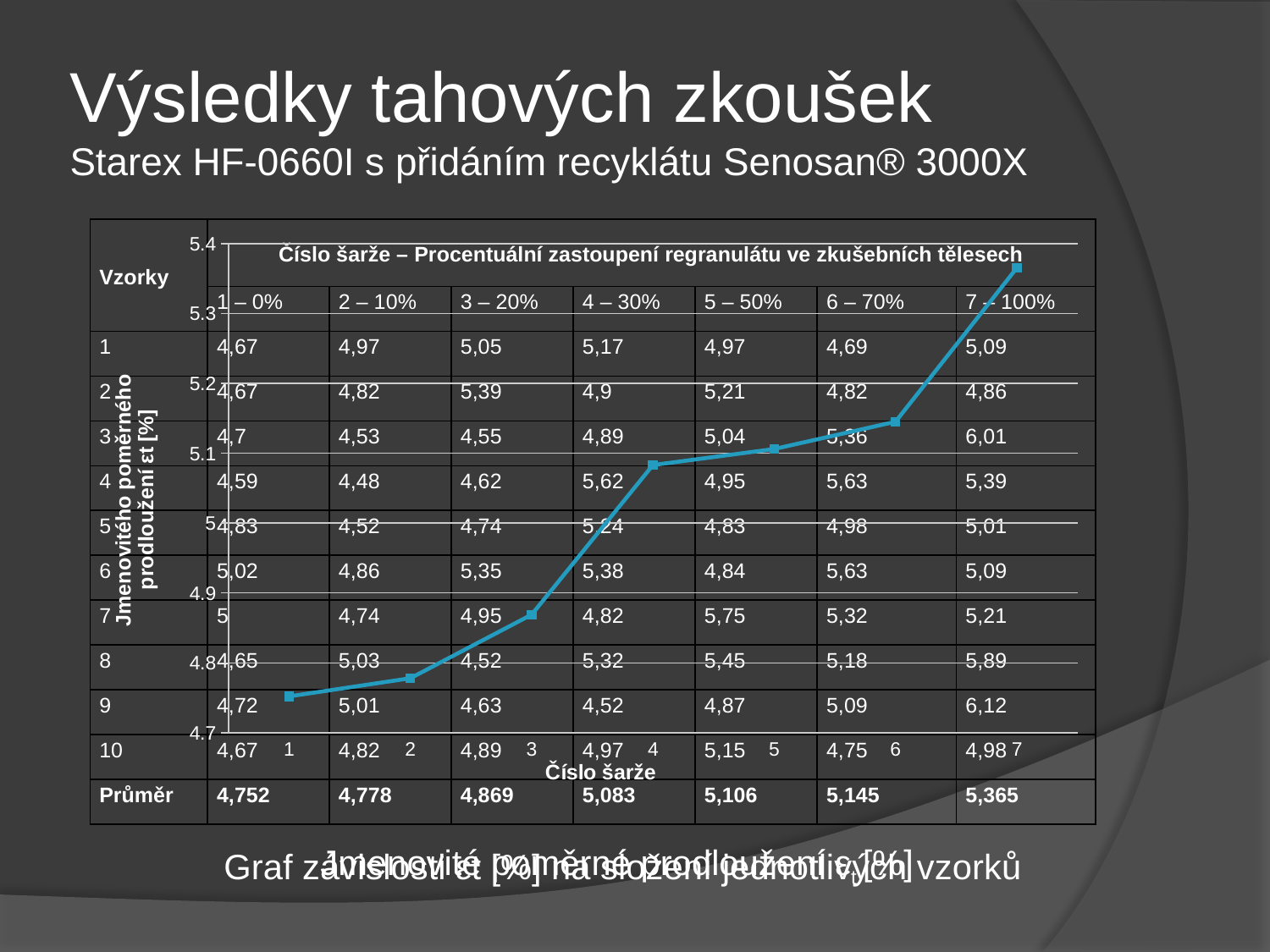
Is the plotted value for batch 7 greater or less than 5.3? greater How many data points are plotted on the line chart? 7 What is the highest tick value shown on the y axis of the line chart? 5.4 Is the plotted value for batch 3 greater or less than 4.9? less Do the plotted values rise or fall as the batch number (Číslo šarže) increases from 1 to 7? rise What is the label of the x axis of the line chart? Číslo šarže Which batch number (Číslo šarže) has the highest plotted value? 7 Is the plotted value for batch 6 greater or less than 5.2? less Which has the larger plotted value, batch 3 or batch 6? batch 6 Which batch number (Číslo šarže) has the lowest plotted value? 1 What kind of chart is shown on the slide? line chart